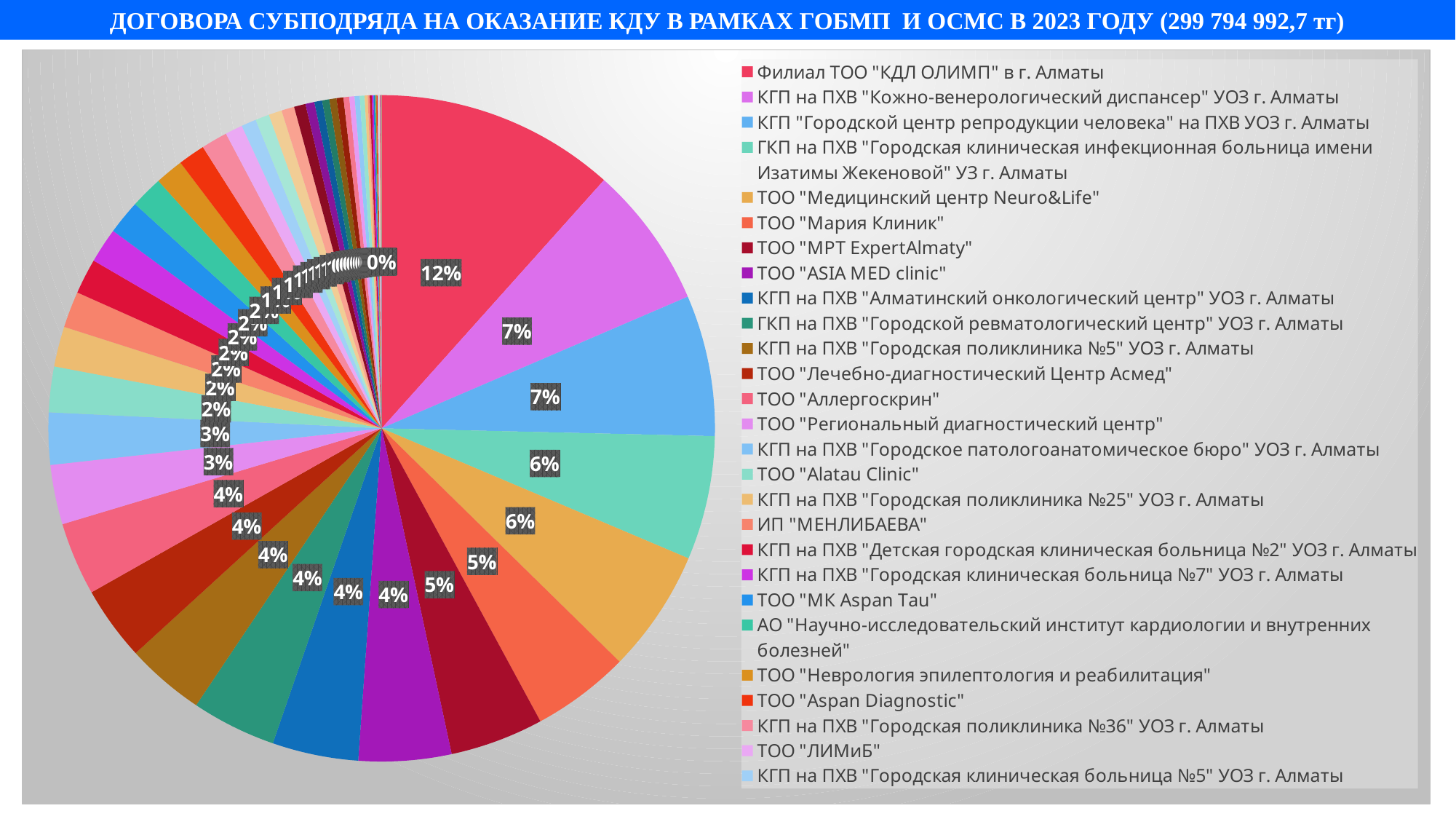
By how many percentage points does the share of Филиал ТОО "КДЛ ОЛИМП" в г. Алматы exceed that of КГП на ПХВ "Кожно-венерологический диспансер" УОЗ г. Алматы? 5 percentage points What total amount in tenge is given in the chart title? 299 794 992,7 тг What share is shown for КГП "Городской центр репродукции человека" на ПХВ УОЗ г. Алматы? 7% Which organisation has the largest slice of the pie? Филиал ТОО "КДЛ ОЛИМП" в г. Алматы What share is shown for ТОО "Медицинский центр Neuro&Life"? 6% Which has the larger share: ТОО "Медицинский центр Neuro&Life" or ТОО "Мария Клиник"? ТОО "Медицинский центр Neuro&Life" What kind of chart is shown on the slide? pie chart What share is shown for ТОО "Мария Клиник"? 5% What share of the pie does Филиал ТОО "КДЛ ОЛИМП" в г. Алматы have? 12% What share is shown for КГП на ПХВ "Кожно-венерологический диспансер" УОЗ г. Алматы? 7% What share is shown for ТОО "ASIA MED clinic"? 4% What share is shown for ТОО "МРТ ExpertAlmaty"? 5%